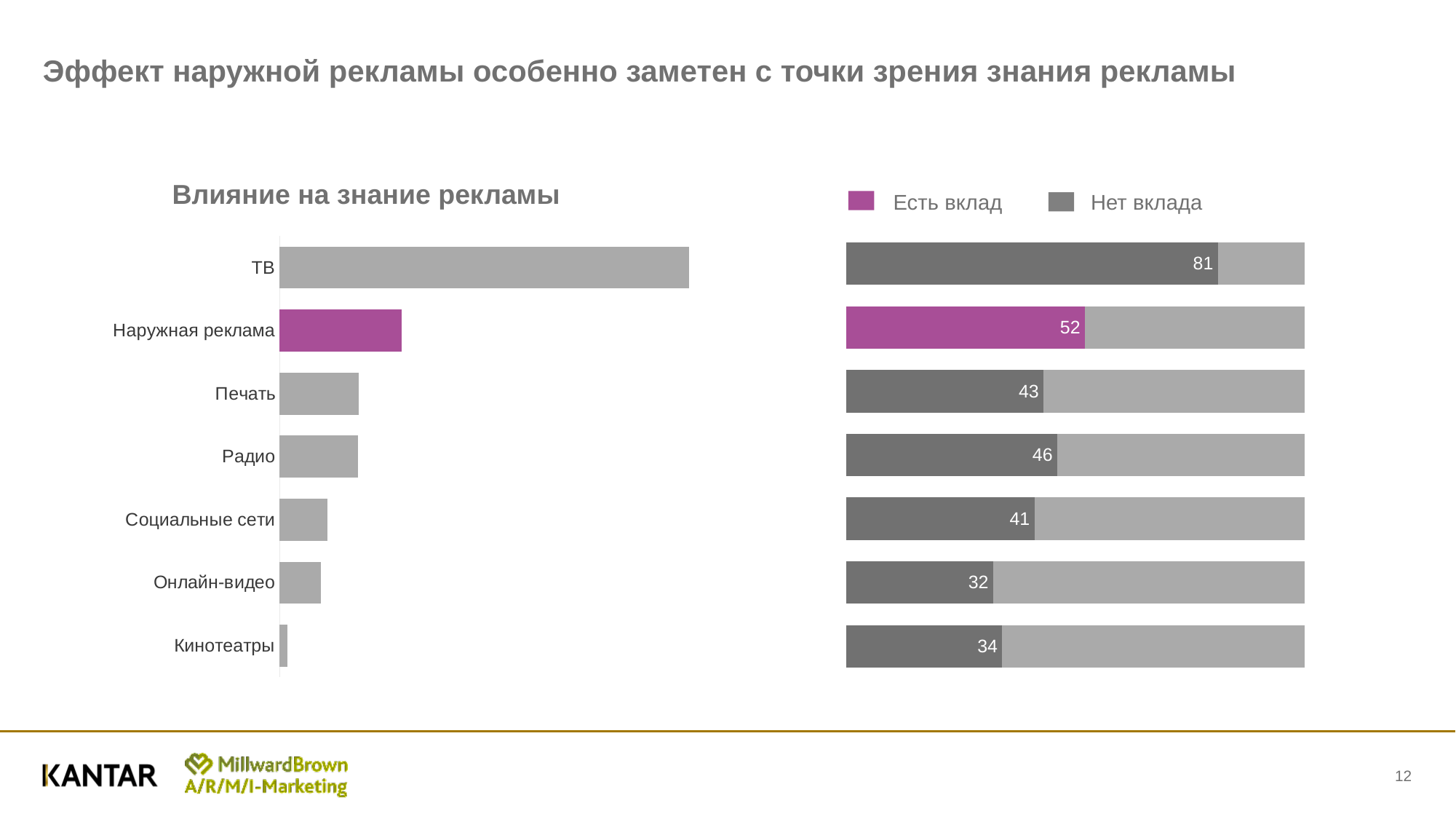
In the right-hand stacked bar chart, what value is printed for Печать? 43 In the right-hand stacked bar chart, what is the difference between the printed values for ТВ and Наружная реклама? 29 In the right-hand stacked bar chart, what value is printed for ТВ? 81 In the right-hand stacked bar chart, what value is printed for Наружная реклама? 52 In the right-hand stacked bar chart, which has the larger printed value, Радио or Социальные сети? Радио How many categories are shown in the chart titled 'Влияние на знание рекламы'? 7 In the right-hand stacked bar chart, what value is printed for Онлайн-видео? 32 In the right-hand stacked bar chart, which category has the lowest printed value? Онлайн-видео In the right-hand stacked bar chart, which category has the highest printed value? ТВ In the chart titled 'Влияние на знание рекламы', which category has the longest bar? ТВ In the chart titled 'Влияние на знание рекламы', which category has the shortest bar? Кинотеатры How many series does the legend on the right-hand chart list? 2